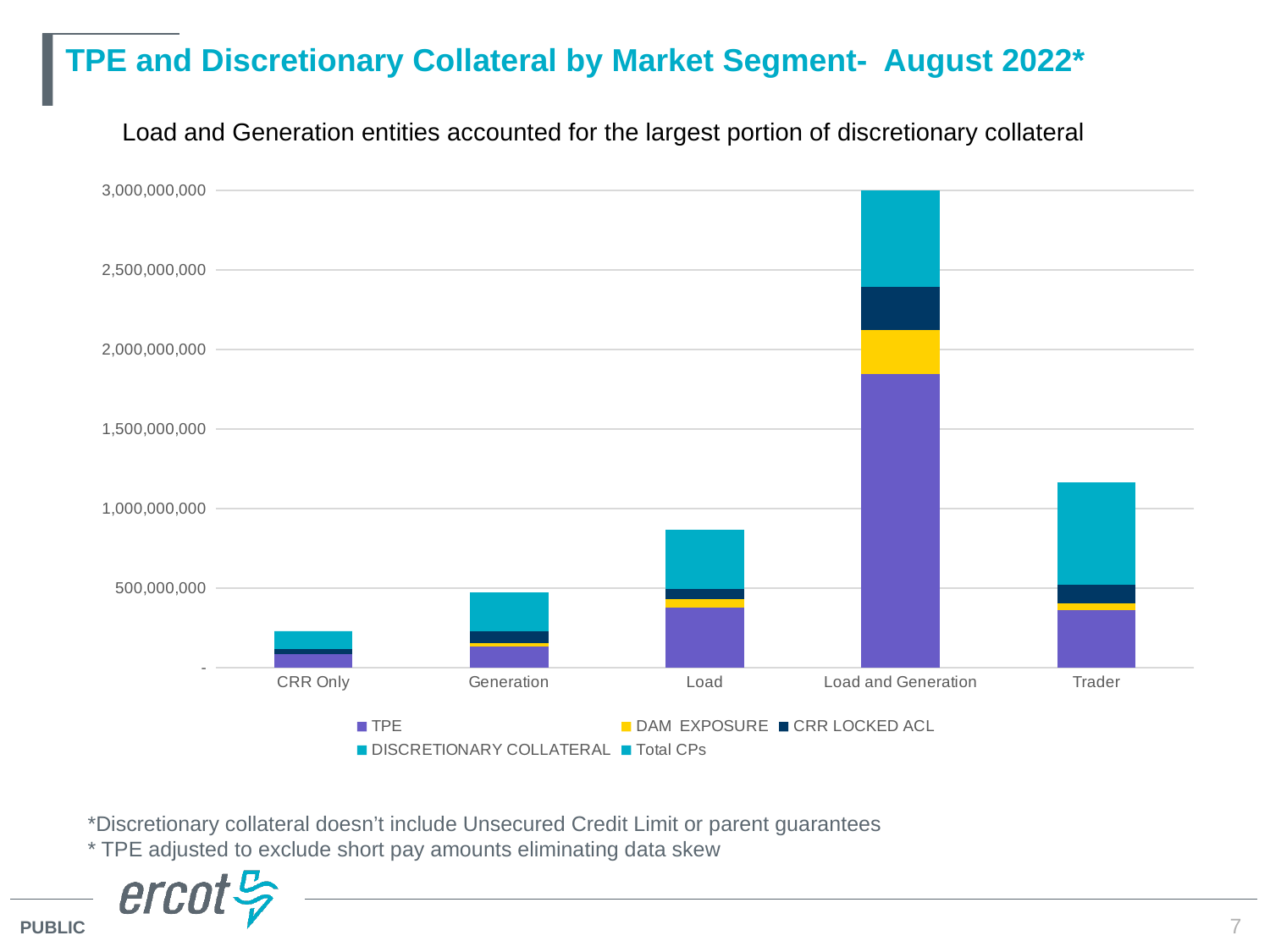
Which market segment has the tallest stacked bar? Load and Generation Is the total stacked bar for Load and Generation greater or less than 2,500,000,000? greater What kind of chart is shown on the slide? Stacked bar chart What is the title of the slide containing the chart? TPE and Discretionary Collateral by Market Segment- August 2022* Which market segment has the shortest stacked bar? CRR Only Is the total stacked bar for Load greater or less than 1,000,000,000? less Is the total stacked bar for Trader greater or less than 1,000,000,000? greater How many series does the legend list? 5 How many market segment categories are shown on the x axis? 5 Which has the taller stacked bar, Trader or Load? Trader Which has the taller stacked bar, Generation or CRR Only? Generation